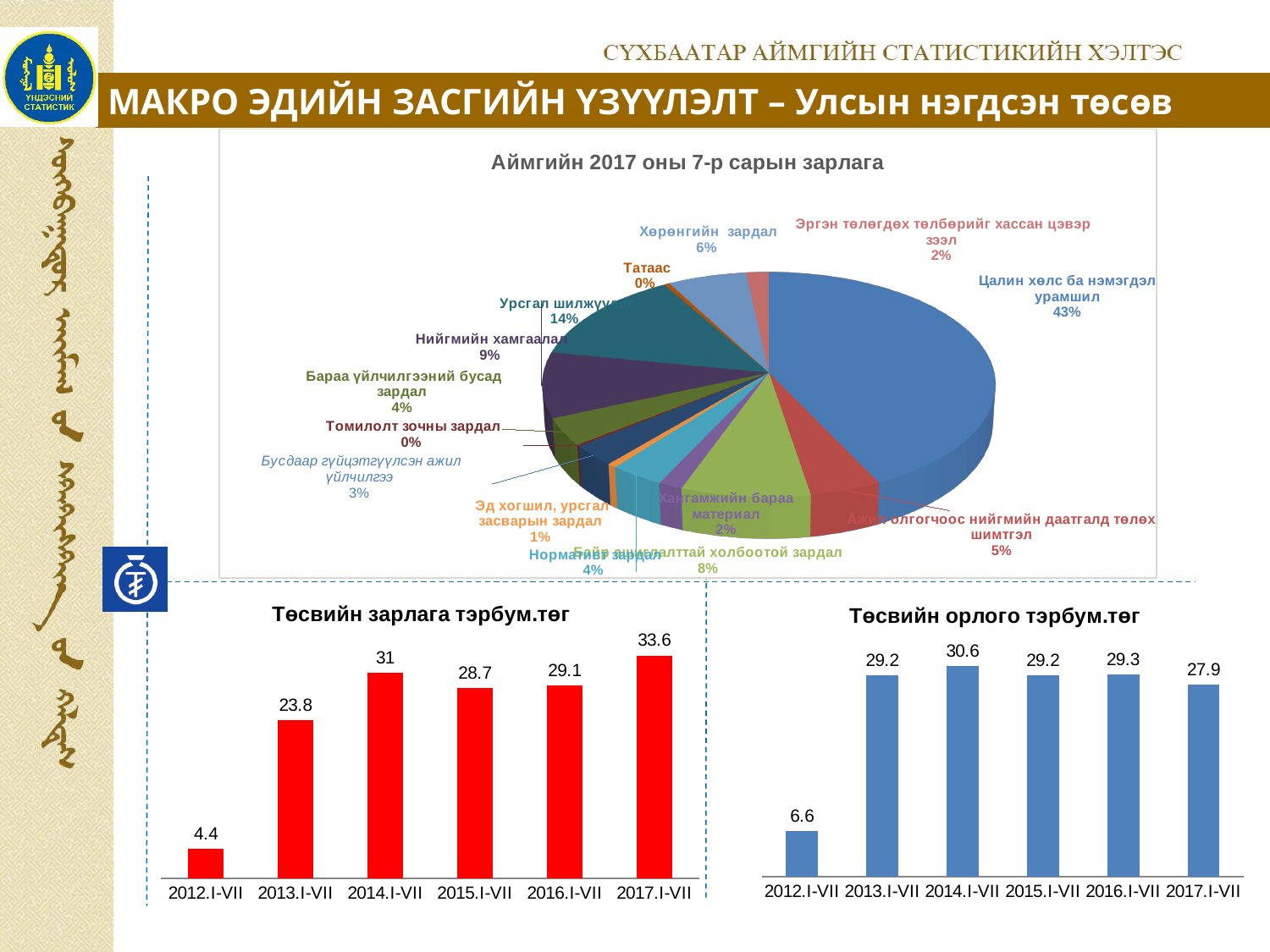
In the pie chart titled 'Аймгийн 2017 оны 7-р сарын зарлага', what share does 'Цалин хөлс ба нэмэгдэл урамшил' have? 43% In the chart titled 'Төсвийн орлого тэрбум.төг', which period has the highest value? 2014.I-VII In the chart titled 'Төсвийн зарлага тэрбум.төг', what is the value for 2017.I-VII? 33.6 In the chart titled 'Төсвийн орлого тэрбум.төг', which is larger, the value for 2013.I-VII or 2017.I-VII? 2013.I-VII In the chart titled 'Төсвийн орлого тэрбум.төг', what is the value for 2014.I-VII? 30.6 How many bars are in the chart titled 'Төсвийн зарлага тэрбум.төг'? 6 In the pie chart titled 'Аймгийн 2017 оны 7-р сарын зарлага', what share does 'Урсгал шилжүүлэг' have? 14% In the pie chart titled 'Аймгийн 2017 оны 7-р сарын зарлага', which category has the largest share? Цалин хөлс ба нэмэгдэл урамшил What kind of chart is the chart titled 'Аймгийн 2017 оны 7-р сарын зарлага'? Pie chart In the chart titled 'Төсвийн зарлага тэрбум.төг', what is the difference between the values for 2017.I-VII and 2016.I-VII? 4.5 What colour are the bars in the chart titled 'Төсвийн зарлага тэрбум.төг'? Red In the chart titled 'Төсвийн зарлага тэрбум.төг', which period has the lowest value? 2012.I-VII